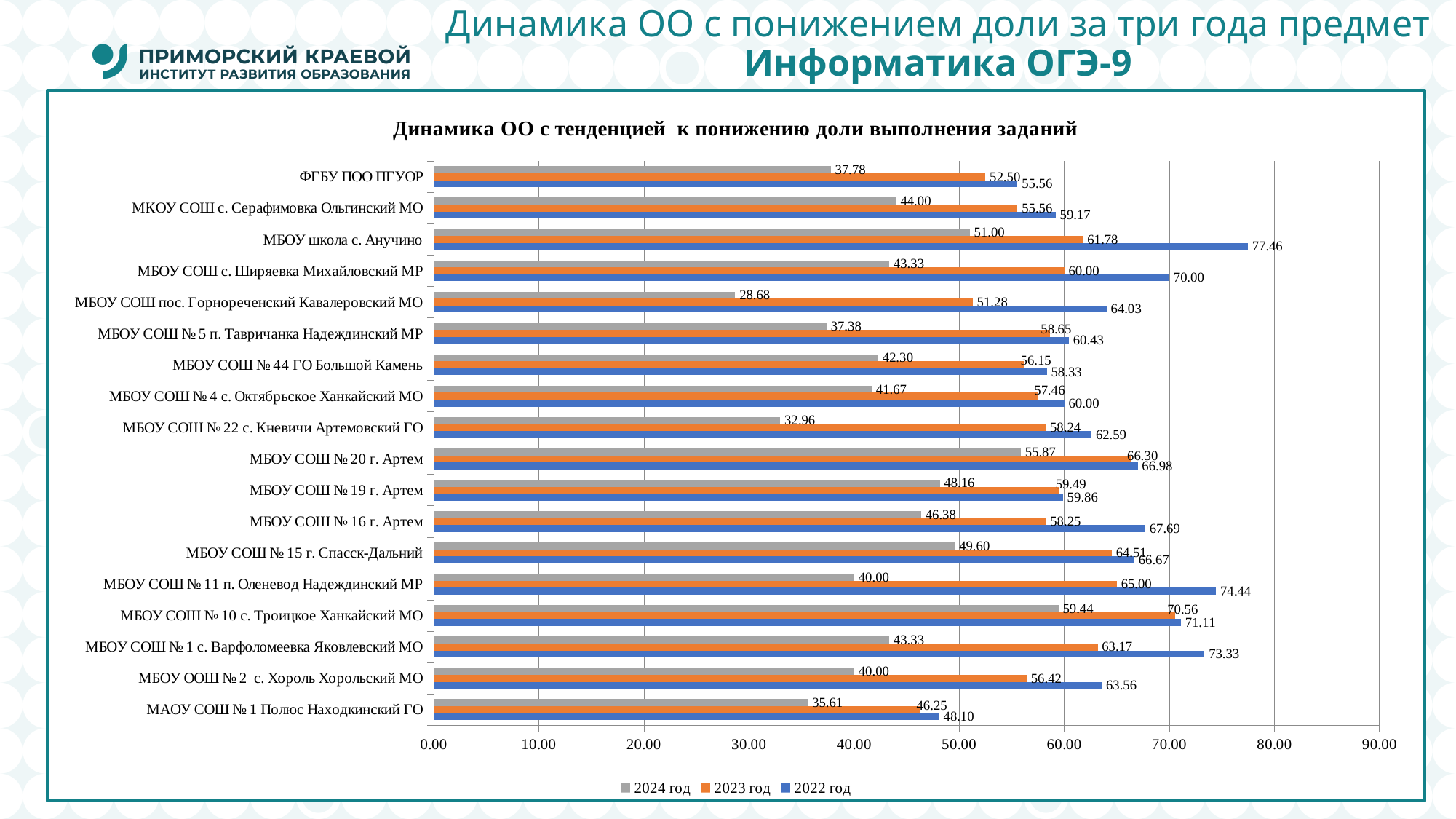
What is the 2024 год value for МБОУ СОШ пос. Горнореченский Кавалеровский МО? 28.68 What is the 2023 год value for МБОУ СОШ № 10 с. Троицкое Ханкайский МО? 70.56 What is the difference between the 2022 год and 2024 год values for МБОУ школа с. Анучино? 26.46 Which organisation has the lowest 2022 год value? МАОУ СОШ № 1 Полюс Находкинский ГО What is the 2022 год value for МБОУ школа с. Анучино? 77.46 How many series does the legend list? 3 Which organisation has the highest 2022 год value? МБОУ школа с. Анучино How many organisations are shown on the chart? 18 What type of chart is shown? bar chart Which organisation has the lowest 2024 год value? МБОУ СОШ пос. Горнореченский Кавалеровский МО What is the title of the chart? Динамика ОО с тенденцией к понижению доли выполнения заданий Which is larger for МБОУ СОШ № 11 п. Оленевод Надеждинский МР: the 2023 год value or the 2022 год value? 2022 год